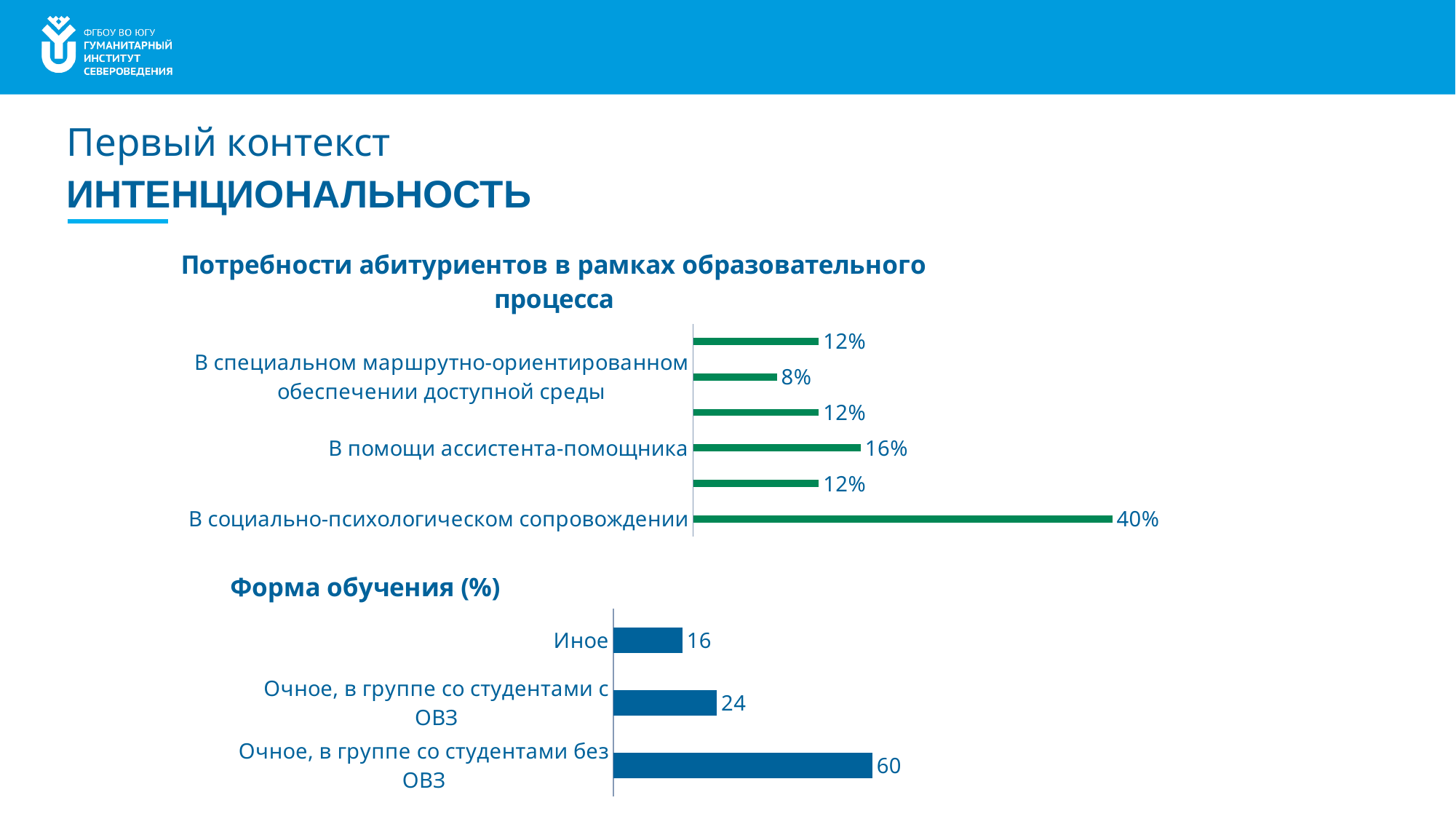
In the chart 'Потребности абитуриентов в рамках образовательного процесса', what is the value for 'В помощи ассистента-помощника'? 16% In the chart 'Потребности абитуриентов в рамках образовательного процесса', what is the difference between 'В социально-психологическом сопровождении' and 'В помощи ассистента-помощника'? 24% In the chart 'Форма обучения (%)', which category has the lowest value? Иное In the chart 'Форма обучения (%)', what is the value for 'Иное'? 16 In the chart 'Потребности абитуриентов в рамках образовательного процесса', what is the value for 'В специальном маршрутно-ориентированном обеспечении доступной среды'? 8% In the chart 'Форма обучения (%)', what is the value for 'Очное, в группе со студентами без ОВЗ'? 60 In the chart 'Потребности абитуриентов в рамках образовательного процесса', what is the value for 'В социально-психологическом сопровождении'? 40% In the chart 'Форма обучения (%)', what is the difference between 'Очное, в группе со студентами без ОВЗ' and 'Очное, в группе со студентами с ОВЗ'? 36 In the chart 'Потребности абитуриентов в рамках образовательного процесса', which category has the highest value? В социально-психологическом сопровождении In the chart 'Форма обучения (%)', which is larger: 'Очное, в группе со студентами с ОВЗ' or 'Иное'? Очное, в группе со студентами с ОВЗ In the chart 'Потребности абитуриентов в рамках образовательного процесса', how many bars are plotted? 6 What type of chart is 'Форма обучения (%)'? Bar chart